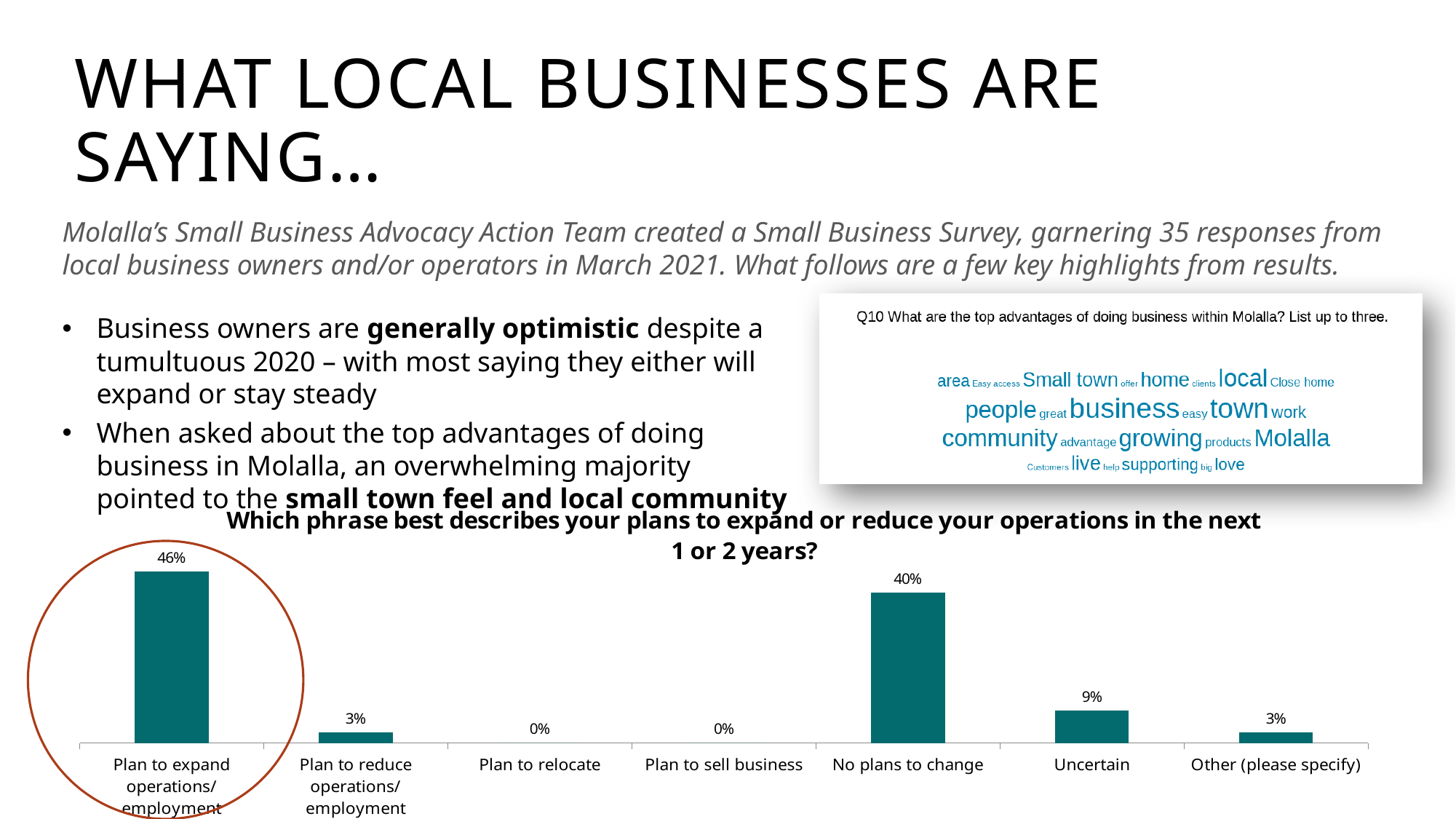
How many categories in the chart have a value of 0%? 2 What percentage of respondents plan to expand operations/employment? 46% Which category has the highest percentage in the chart? Plan to expand operations/employment What percentage of respondents are uncertain about their plans? 9% What is the difference in percentage points between 'Uncertain' and 'Other (please specify)'? 6% Which is larger: the value for 'Uncertain' or the value for 'Plan to reduce operations/employment'? Uncertain What is the title of the bar chart? Which phrase best describes your plans to expand or reduce your operations in the next 1 or 2 years? What percentage of respondents plan to relocate? 0% What percentage of respondents said they have no plans to change? 40% What type of chart is used to show the plans to expand or reduce operations? Bar chart How many categories are shown on the x axis of the chart? 7 What is the difference in percentage points between 'Plan to expand operations/employment' and 'No plans to change'? 6%